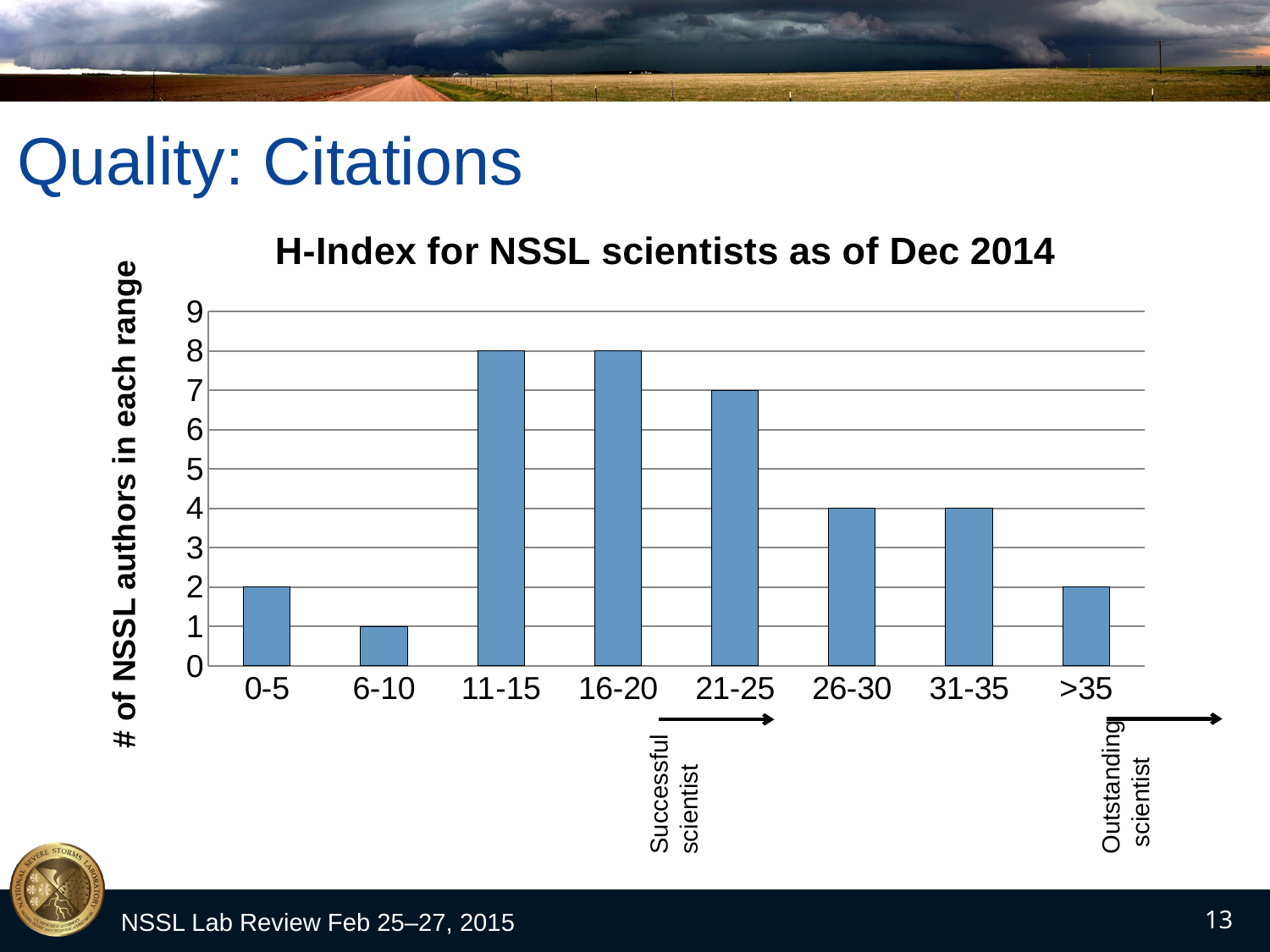
What is the label on the y axis? # of NSSL authors in each range Is the value for the 16-20 range greater or less than 5? greater How many NSSL authors have an H-index in the 21-25 range? 7 Which range has more NSSL authors, 21-25 or 31-35? 21-25 What is the difference between the number of authors in the 11-15 range and the number in the 0-5 range? 6 What is the chart title? H-Index for NSSL scientists as of Dec 2014 Which H-index range has the fewest NSSL authors? 6-10 How many NSSL authors have an H-index in the 26-30 range? 4 What kind of chart is shown on the slide? bar chart How many NSSL authors have an H-index in the 6-10 range? 1 How many H-index ranges are shown on the x axis? 8 How many NSSL authors have an H-index greater than 35? 2